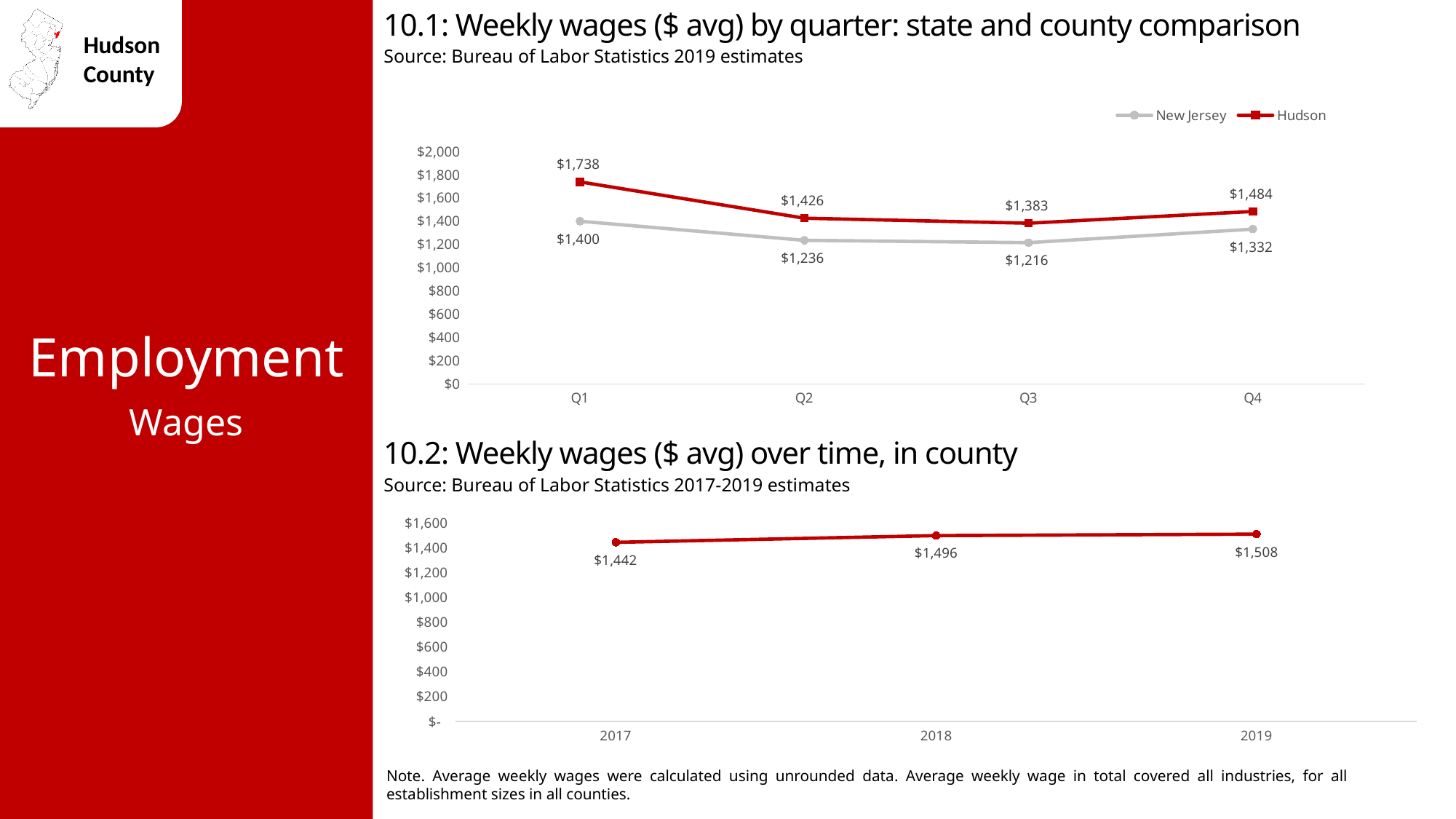
In chart 10.1 (weekly wages by quarter), how many series does the legend list? 2 In chart 10.1 (weekly wages by quarter), what is the difference between the Hudson and New Jersey values in Q4? $152 In chart 10.2 (weekly wages over time, in county), what is the value for 2018? $1,496 In chart 10.2 (weekly wages over time, in county), what is the difference between the 2019 and 2017 values? $66 In chart 10.1 (weekly wages by quarter), what is the Hudson value for Q1? $1,738 In chart 10.1 (weekly wages by quarter), what is the New Jersey value for Q3? $1,216 In chart 10.1 (weekly wages by quarter), which quarter has the lowest New Jersey value? Q3 In chart 10.2 (weekly wages over time, in county), do the values rise or fall from 2017 to 2019? Rise In chart 10.1 (weekly wages by quarter), which quarter has the highest Hudson value? Q1 In chart 10.2 (weekly wages over time, in county), how many years are plotted? 3 In chart 10.1 (weekly wages by quarter), what kind of chart is shown? Line chart In chart 10.1 (weekly wages by quarter), which is larger in Q2: Hudson or New Jersey? Hudson